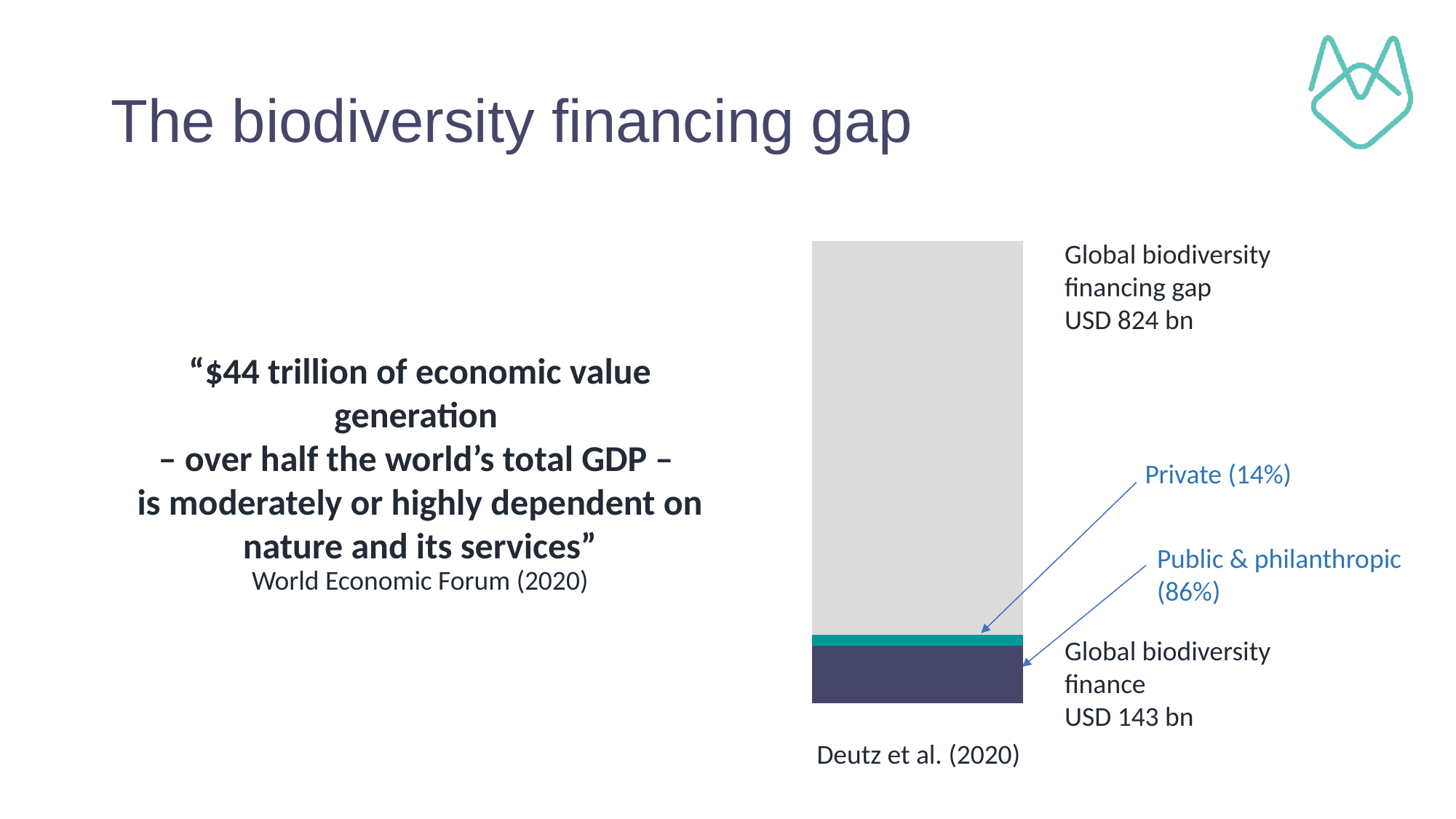
Which segment of the bar is larger: Private or Public & philanthropic? Public & philanthropic What source is cited beneath the chart? Deutz et al. (2020) What share of global biodiversity finance comes from public & philanthropic sources, according to the chart? 86% What colour is the segment representing the global biodiversity financing gap? Grey What is the value of the global biodiversity financing gap shown on the chart? USD 824 bn What is the combined total of the global biodiversity financing gap and global biodiversity finance, in USD bn? 967 How many segments make up the bar on the chart? 3 Which is larger on the chart: the global biodiversity financing gap or global biodiversity finance? Global biodiversity financing gap By how much does the global biodiversity financing gap exceed global biodiversity finance, in USD bn? 681 What share of global biodiversity finance comes from private sources, according to the chart? 14% What kind of chart is shown on the slide? Stacked bar chart What is the value of global biodiversity finance shown on the chart? USD 143 bn